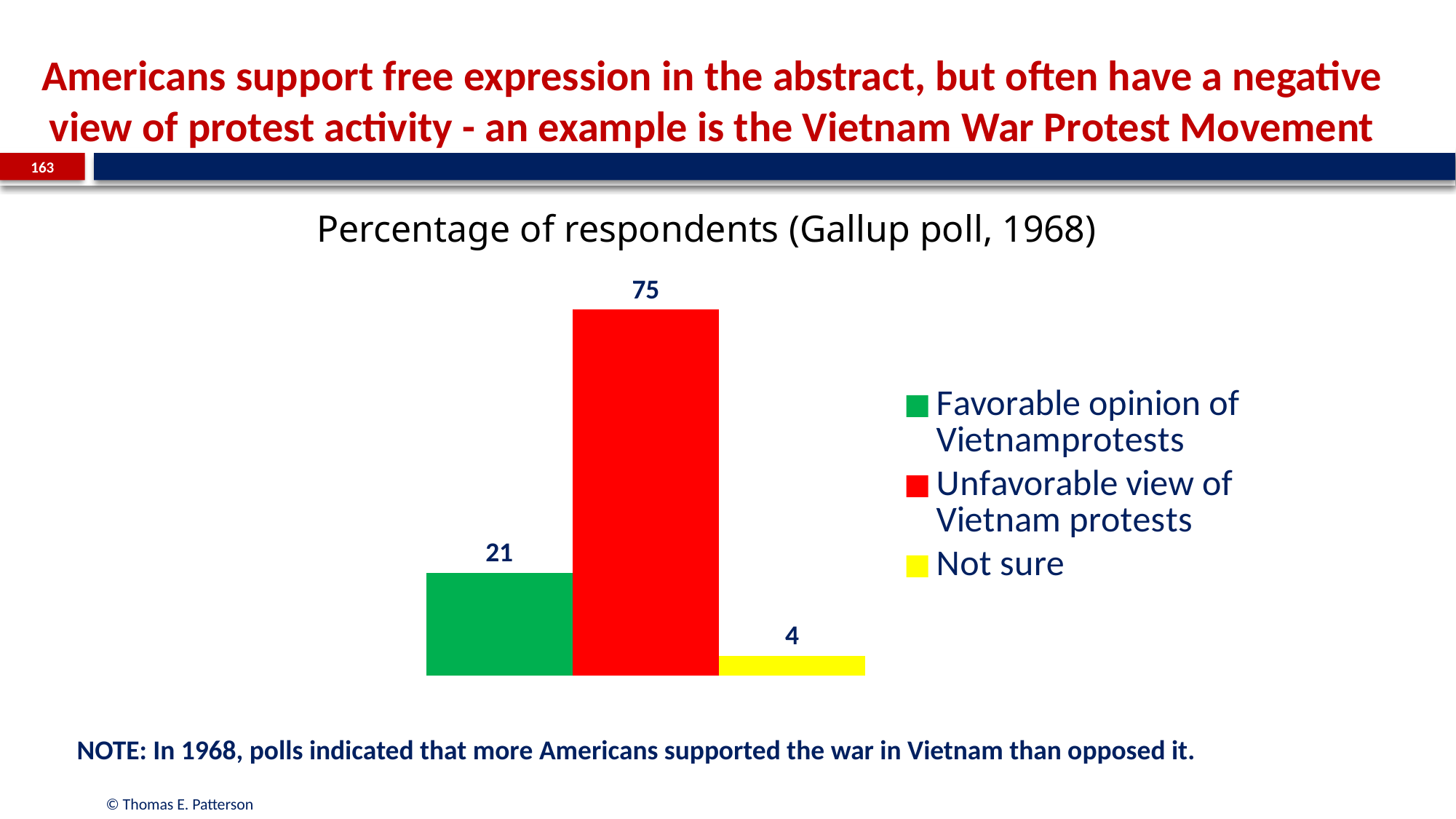
What colour is the bar for 'Not sure'? Yellow What is the value for 'Not sure'? 4 What is the difference between the 'Unfavorable view of Vietnam protests' value and the 'Favorable opinion of Vietnam protests' value? 54 Which is larger: the value for 'Favorable opinion of Vietnam protests' or the value for 'Not sure'? Favorable opinion of Vietnam protests How many series does the legend list? 3 What is the value for 'Unfavorable view of Vietnam protests'? 75 What is the difference between the 'Favorable opinion of Vietnam protests' value and the 'Not sure' value? 17 What is the title of the chart? Percentage of respondents (Gallup poll, 1968) What is the value for 'Favorable opinion of Vietnam protests'? 21 Which category has the highest value? Unfavorable view of Vietnam protests Which category has the lowest value? Not sure What kind of chart is shown on the slide? Bar chart